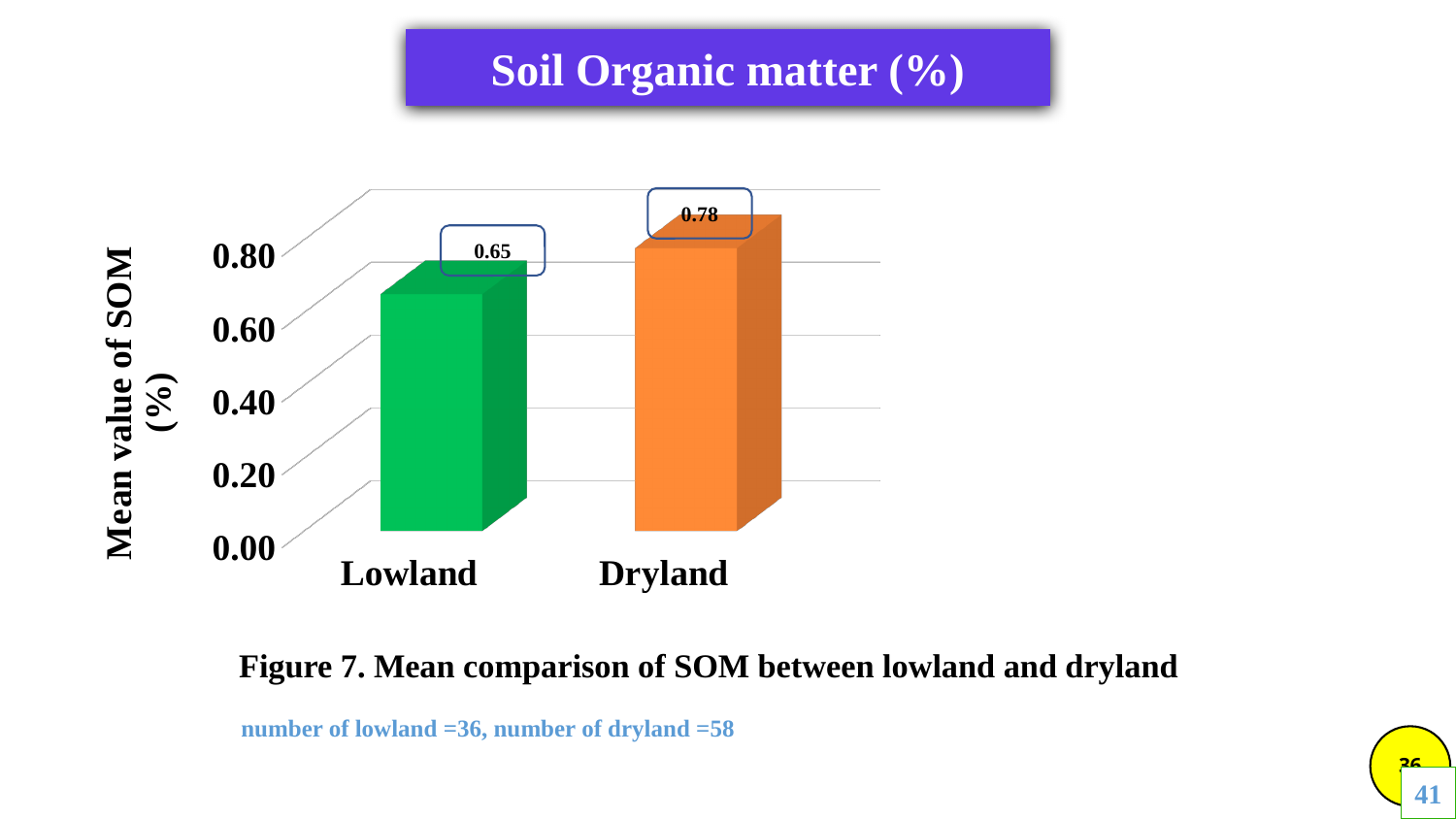
How many categories are shown on the x axis? 2 What kind of chart is shown on the slide? bar chart Is the value for Dryland greater or less than 0.80? less Is the mean SOM value for Lowland larger or smaller than that for Dryland? smaller What colour is the Dryland bar? orange What is the mean value of SOM for Dryland? 0.78 Is the value for Lowland greater or less than 0.60? greater What is the mean value of SOM for Lowland? 0.65 Which category has the higher mean SOM value? Dryland What is the difference between the Dryland and Lowland mean SOM values? 0.13 What is the label of the vertical axis? Mean value of SOM (%) Which category has the lower mean SOM value? Lowland